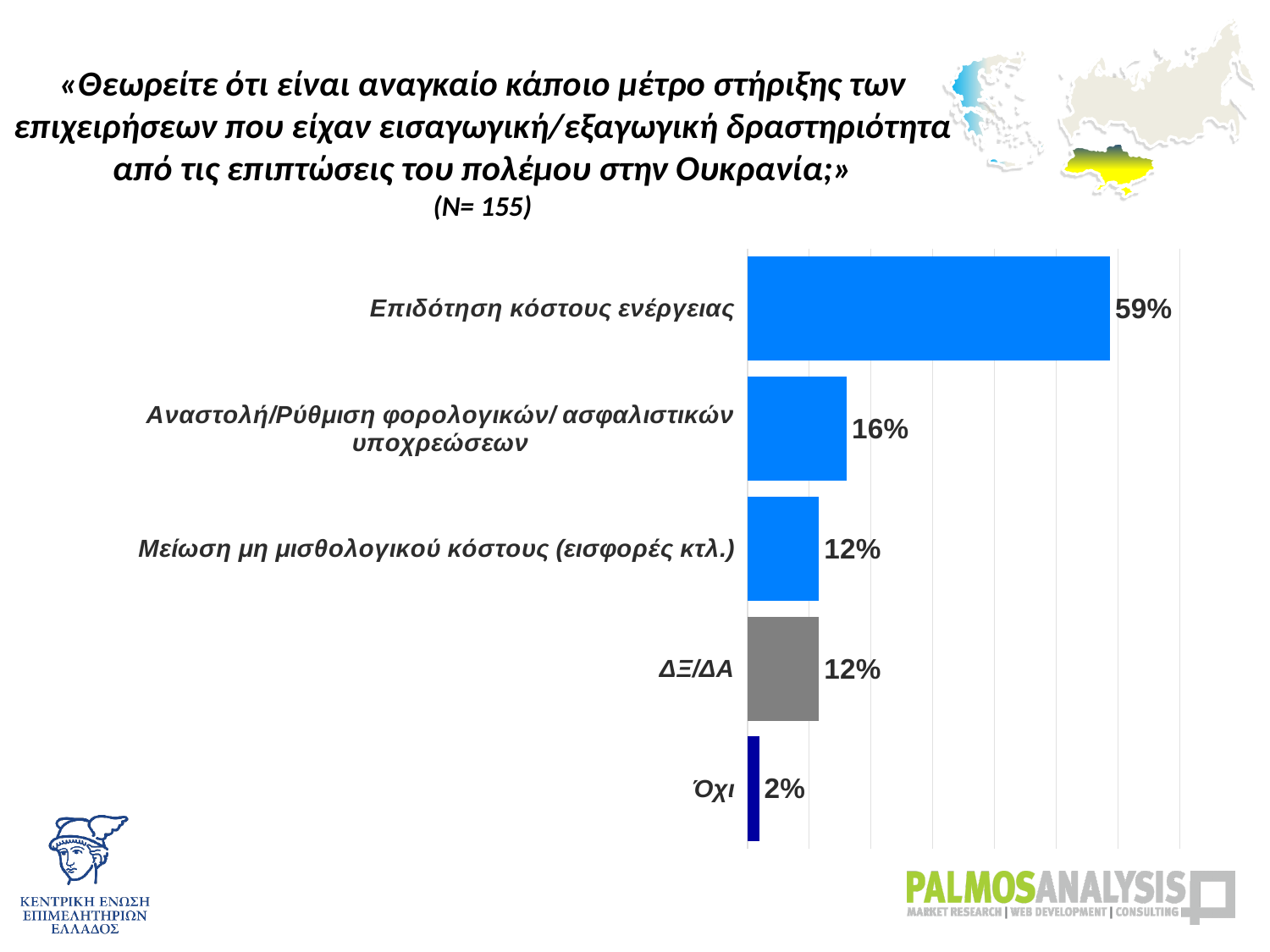
What is the value for Μείωση μη μισθολογικού κόστους (εισφορές κτλ.)? 12% What is the value for Αναστολή/Ρύθμιση φορολογικών/ ασφαλιστικών υποχρεώσεων? 16% How many categories are shown in the chart? 5 What is the difference between the values for Επιδότηση κόστους ενέργειας and Αναστολή/Ρύθμιση φορολογικών/ ασφαλιστικών υποχρεώσεων? 43% What is the sample size (N) stated under the chart title? 155 What is the value for Επιδότηση κόστους ενέργειας? 59% What is the value for ΔΞ/ΔΑ? 12% Which category has the lowest value? Όχι Which is larger, the value for Αναστολή/Ρύθμιση φορολογικών/ ασφαλιστικών υποχρεώσεων or the value for Όχι? Αναστολή/Ρύθμιση φορολογικών/ ασφαλιστικών υποχρεώσεων Which category has the highest value? Επιδότηση κόστους ενέργειας What is the value for Όχι? 2% What kind of chart is shown on the slide? Bar chart